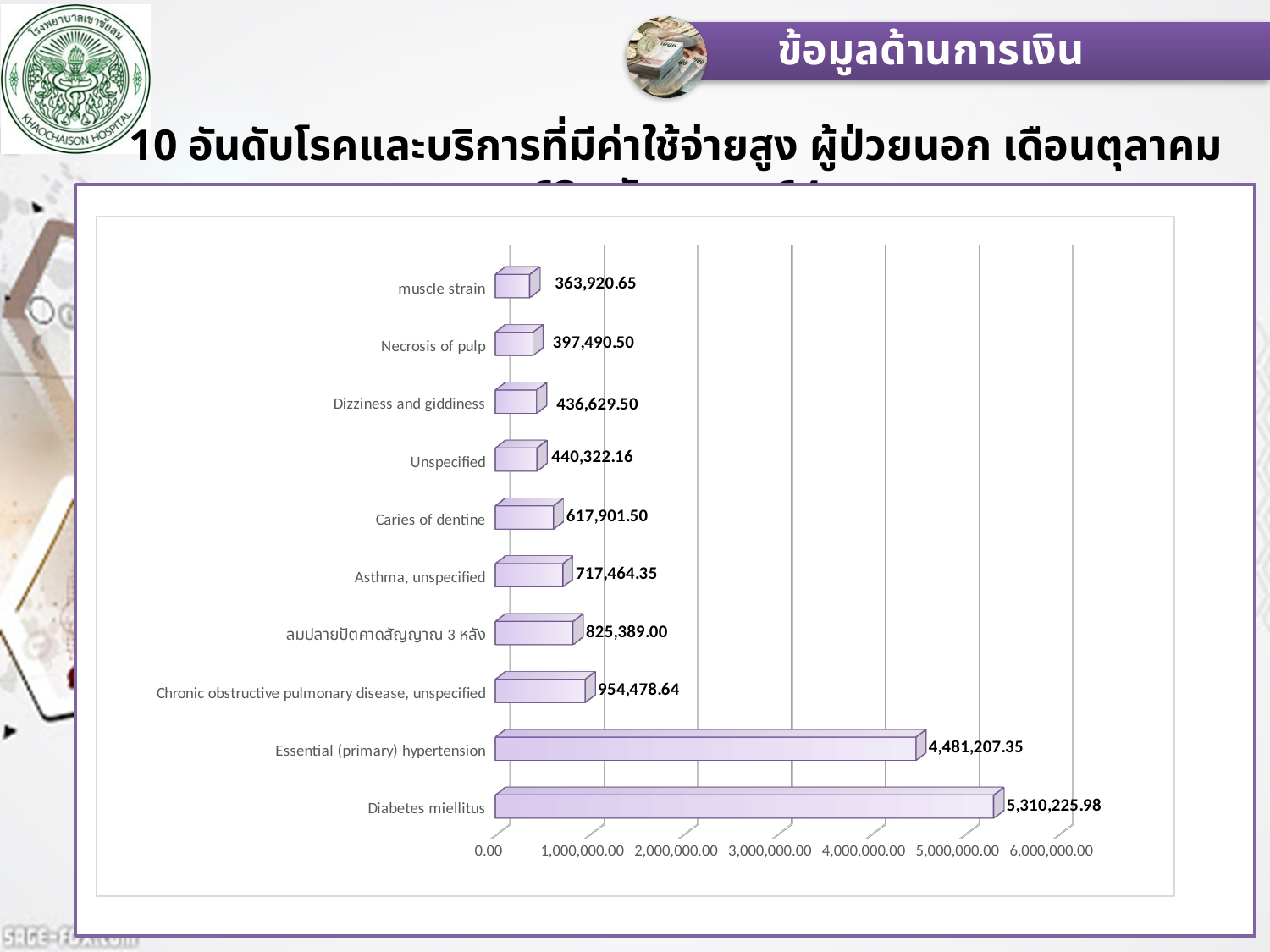
Which category has the highest value? Diabetes miellitus Which is larger, the value for Asthma, unspecified or the value for Caries of dentine? Asthma, unspecified What kind of chart is shown on the slide? Bar chart Which category has the lowest value? muscle strain What is the value for Chronic obstructive pulmonary disease, unspecified? 954,478.64 How many categories are shown in the chart? 10 What is the value for Diabetes miellitus? 5,310,225.98 What is the value for Caries of dentine? 617,901.50 What is the value for Essential (primary) hypertension? 4,481,207.35 What is the difference between the values for Diabetes miellitus and Essential (primary) hypertension? 829,018.63 Is the value for Essential (primary) hypertension greater or less than 4,000,000.00? greater What is the value for muscle strain? 363,920.65